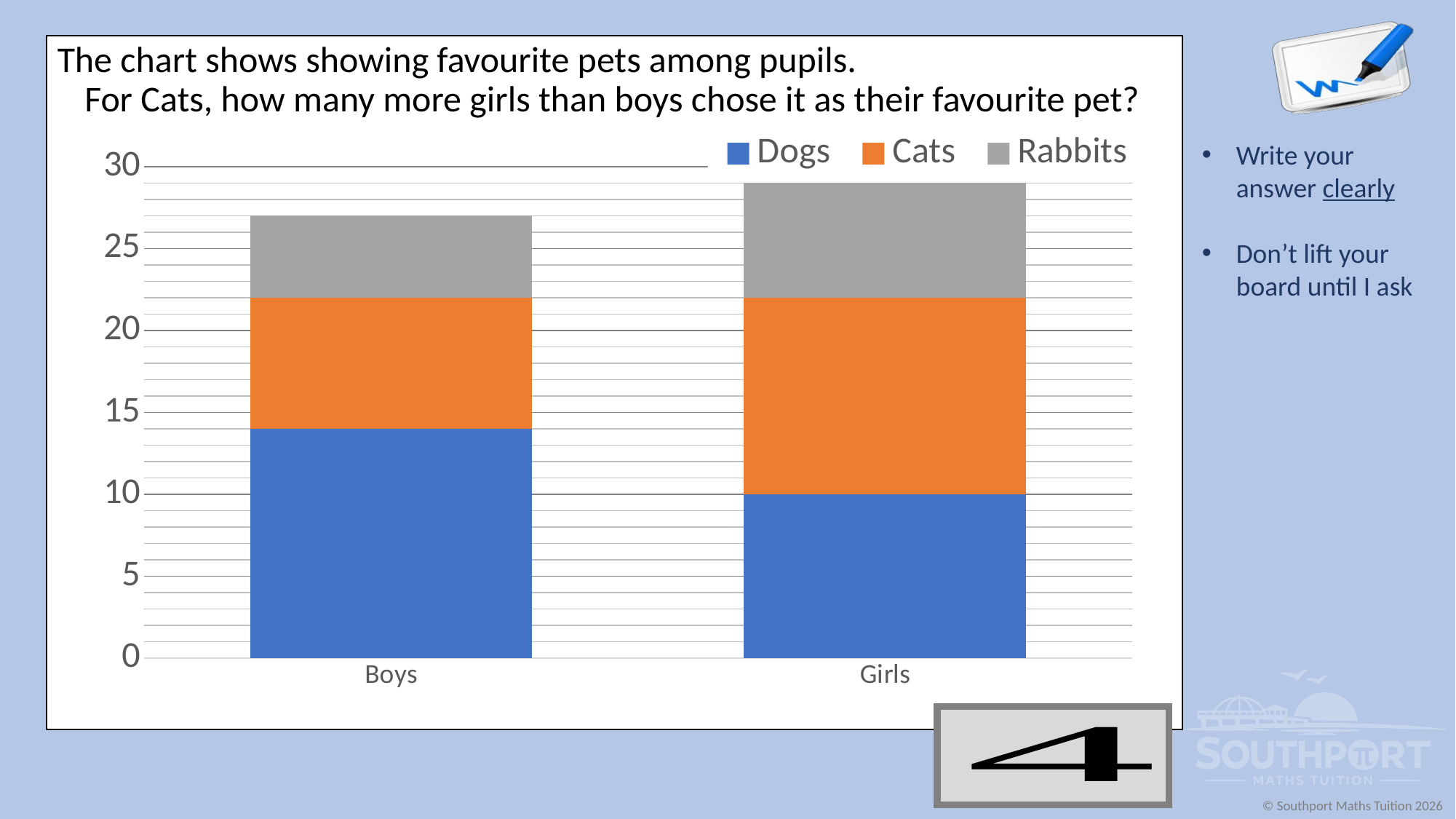
Which category has the larger Cats segment, Boys or Girls? Girls How many categories are shown on the x axis? 2 Is the total height of the Boys bar greater or less than 30? less Is the value for Dogs among Boys greater or less than 10? greater What are the three series named in the legend? Dogs, Cats, Rabbits Which category has the taller stacked bar overall, Boys or Girls? Girls Is the total height of the Girls bar greater or less than 25? greater Which category has the larger Dogs segment, Boys or Girls? Boys How many series does the legend list? 3 What kind of chart is shown on the slide? Stacked bar chart What is the value for Dogs among Girls? 10 Which colour represents Cats in the chart? Orange